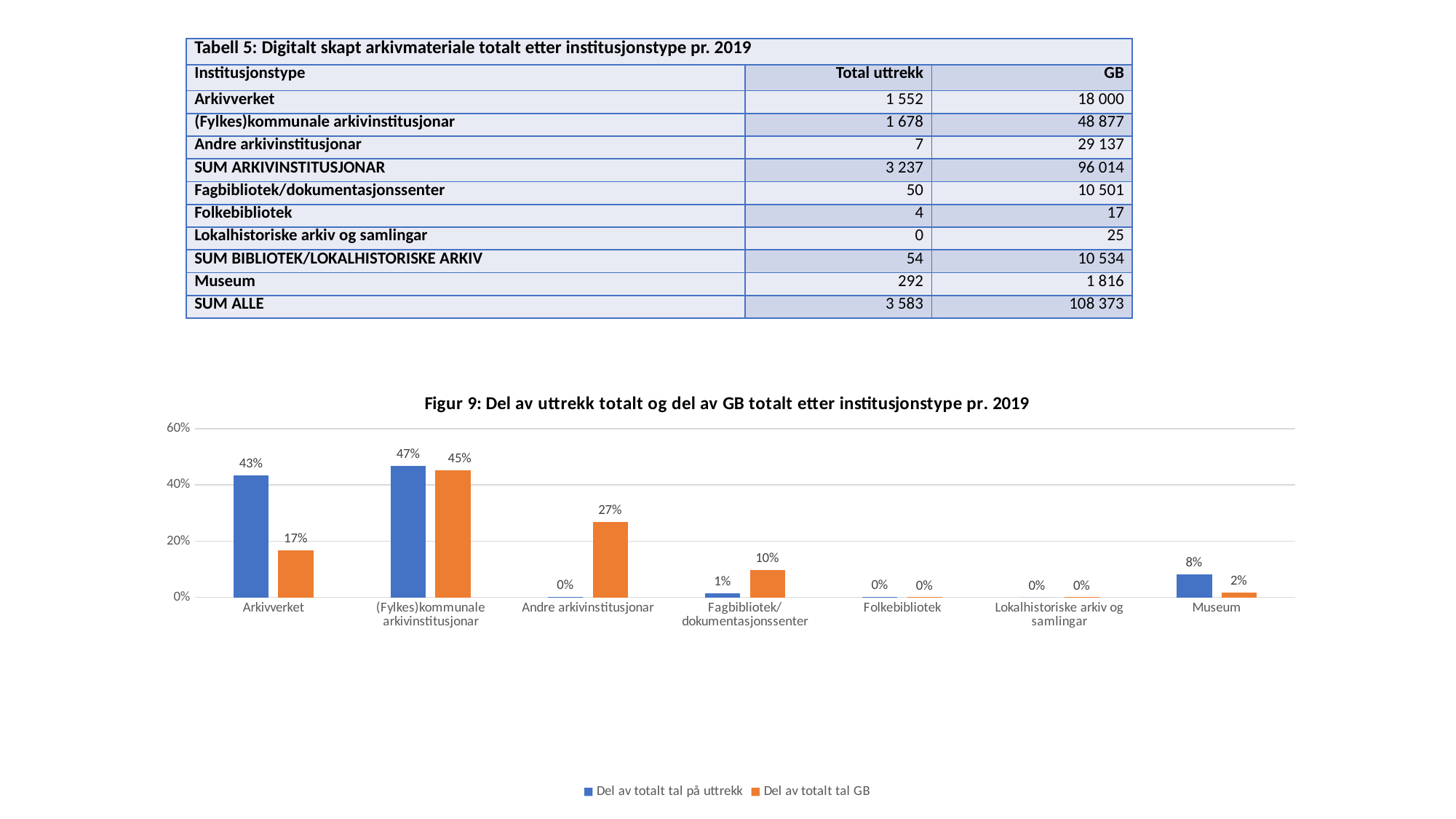
What type of chart is Figur 9? bar chart In Figur 9, which institution type has the lowest value for 'Del av totalt tal GB' among Arkivverket, (Fylkes)kommunale arkivinstitusjonar, Andre arkivinstitusjonar and Museum? Museum In Figur 9, which colour represents the series 'Del av totalt tal GB'? orange How many series does the legend of Figur 9 list? 2 In Figur 9, which institution type has the highest value for 'Del av totalt tal på uttrekk'? (Fylkes)kommunale arkivinstitusjonar In Figur 9, is the value of 'Del av totalt tal GB' for (Fylkes)kommunale arkivinstitusjonar greater or less than 40%? greater In Figur 9, what is the value of 'Del av totalt tal på uttrekk' for Arkivverket? 43% In Figur 9, what is the value of 'Del av totalt tal GB' for Andre arkivinstitusjonar? 27% How many institution types are shown on the x axis of Figur 9? 7 In Figur 9, what is the value of 'Del av totalt tal GB' for Museum? 2% In Figur 9, which is larger for Fagbibliotek/dokumentasjonssenter: 'Del av totalt tal på uttrekk' or 'Del av totalt tal GB'? Del av totalt tal GB In Figur 9, what is the difference between 'Del av totalt tal på uttrekk' and 'Del av totalt tal GB' for Arkivverket? 26%